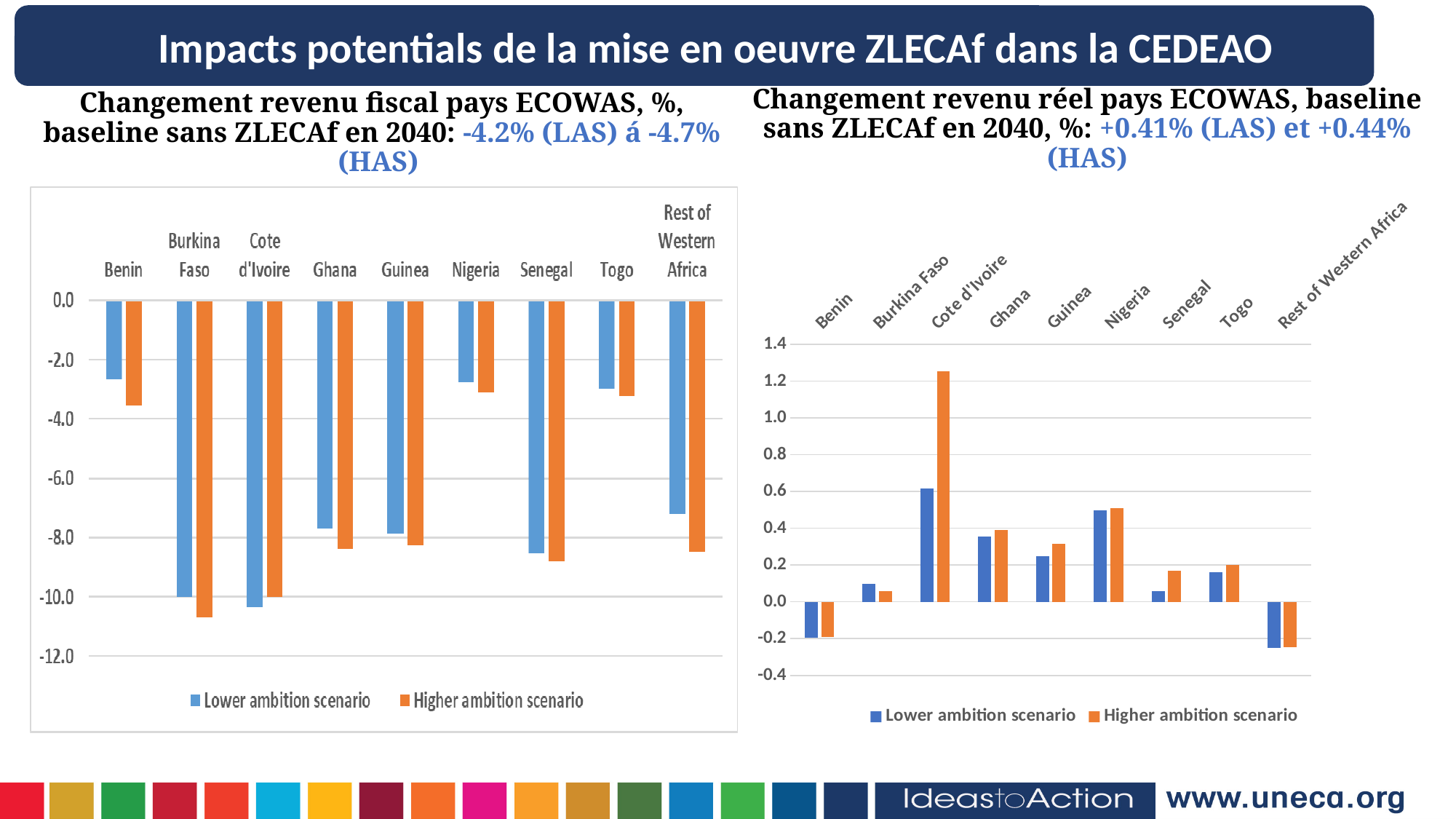
What colour represents the Higher ambition scenario in both charts? orange In the right chart (real income change), which country has the highest Higher ambition scenario value? Cote d'Ivoire How many series does the legend of the right chart (real income change) list? 2 In the left chart (fiscal revenue change), which country has the most negative Higher ambition scenario value? Burkina Faso In the right chart (real income change), which is larger for Senegal: the Lower ambition scenario or the Higher ambition scenario? Higher ambition scenario What kind of chart is the left chart, 'Changement revenu fiscal pays ECOWAS'? bar chart In the left chart (fiscal revenue change), which is more negative for Ghana: the Lower ambition scenario or the Higher ambition scenario? Higher ambition scenario In the left chart (fiscal revenue change), is the Lower ambition scenario value for Benin greater or less than -4.0? greater In the left chart (fiscal revenue change), is the Higher ambition scenario value for Burkina Faso greater or less than -10.0? less In the right chart (real income change), is the Higher ambition scenario value for Cote d'Ivoire greater or less than 1.2? greater How many countries or regions are shown on the x axis of the left chart (fiscal revenue change)? 9